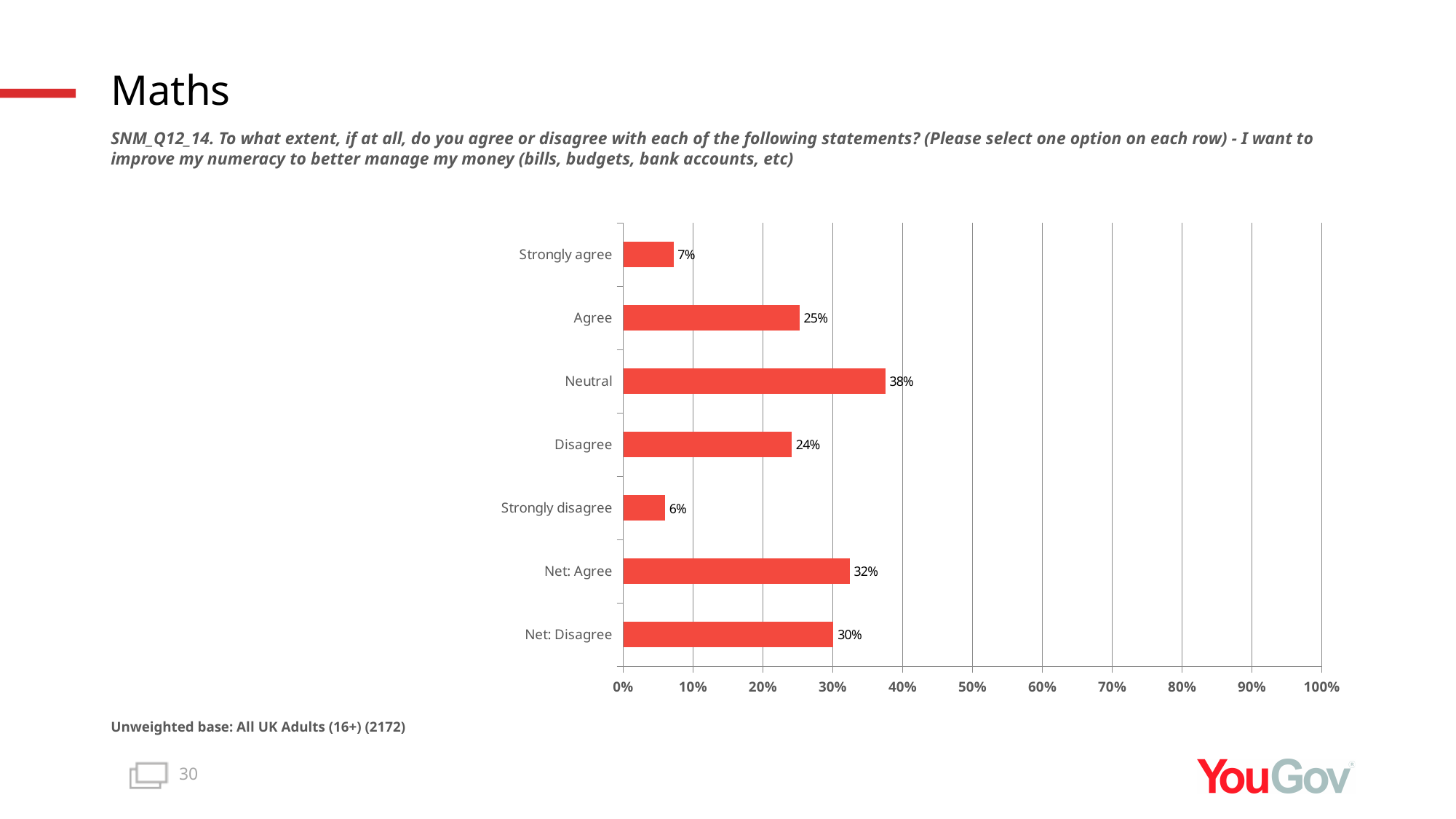
Is the value for 'Neutral' greater or less than 30%? greater What is the unweighted base stated below the chart? All UK Adults (16+) (2172) Which category has the highest value? Neutral What is the value shown for 'Strongly agree'? 7% What kind of chart is shown on the slide? Bar chart What is the difference between 'Net: Agree' and 'Net: Disagree'? 2% Which category has the lowest value? Strongly disagree What is the difference between 'Neutral' and 'Agree'? 13% How many categories are shown on the chart? 7 Which is larger, 'Agree' or 'Disagree'? Agree What percentage of respondents selected 'Neutral'? 38% What is the value shown for 'Net: Disagree'? 30%